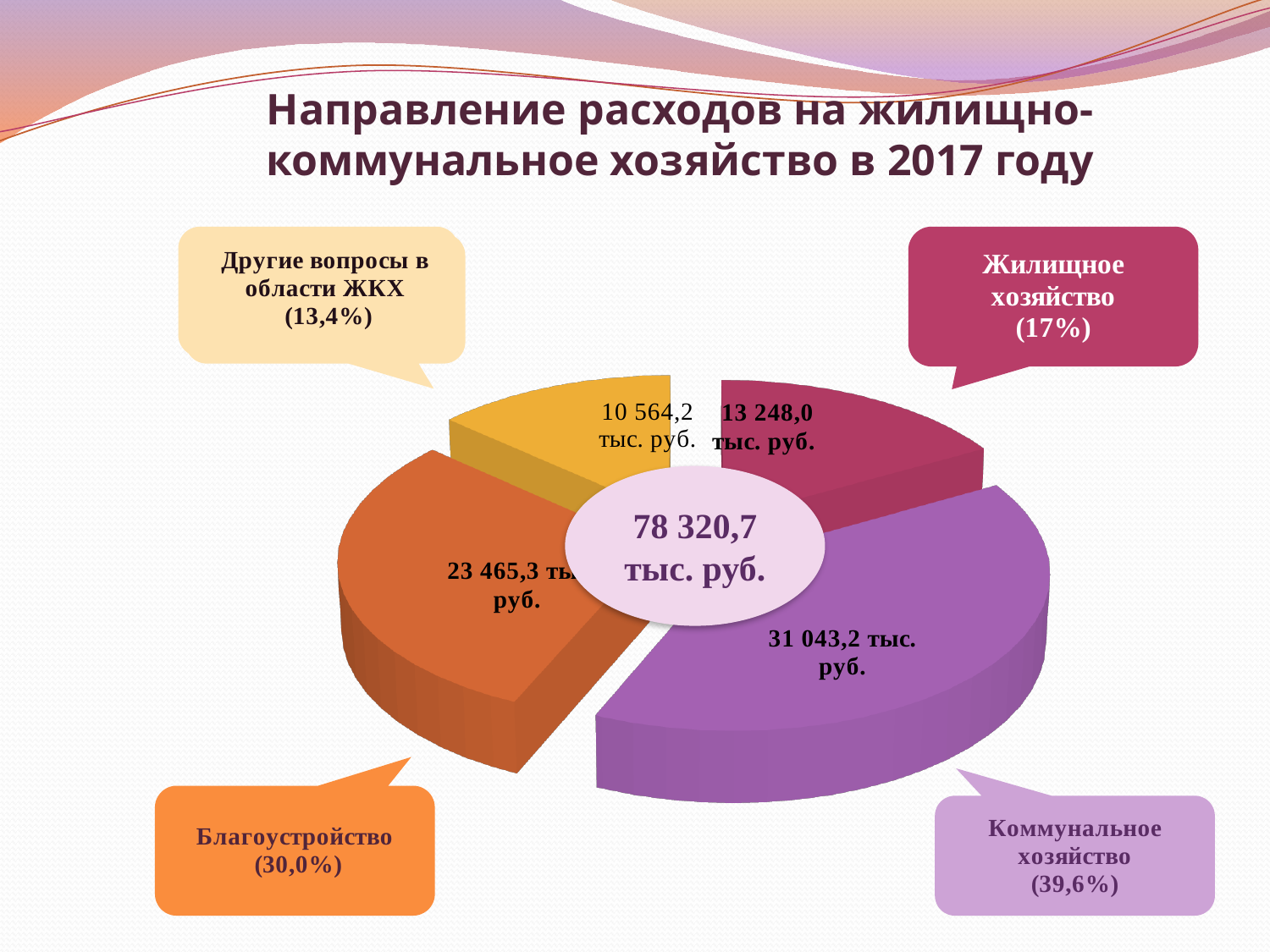
What total is shown in the centre of the pie chart? 78 320,7 тыс. руб. What share of the pie does Благоустройство represent? 30,0% How many slices does the pie chart have? 4 What is the difference between the values for Коммунальное хозяйство and Благоустройство? 7 577,9 тыс. руб. Which category has the largest slice? Коммунальное хозяйство What kind of chart is shown on the slide? pie chart What is the value for Коммунальное хозяйство? 31 043,2 тыс. руб. What is the value for Другие вопросы в области ЖКХ? 10 564,2 тыс. руб. Which category has the smallest slice? Другие вопросы в области ЖКХ What share of the pie does Жилищное хозяйство represent? 17% What is the value for Благоустройство? 23 465,3 тыс. руб. What is the value for Жилищное хозяйство? 13 248,0 тыс. руб.